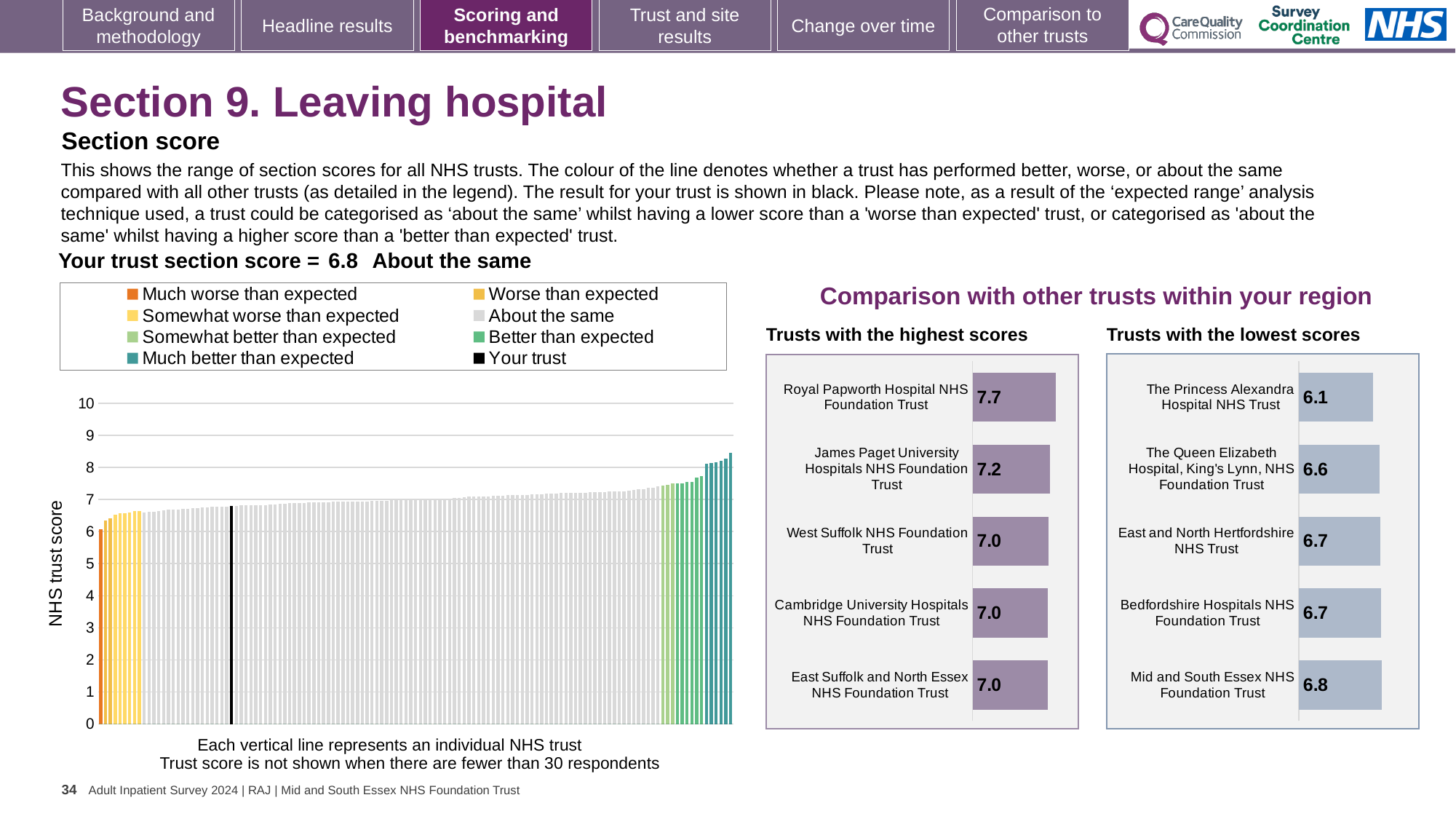
In the 'Trusts with the highest scores' chart, what is the difference between the scores of Royal Papworth Hospital NHS Foundation Trust and West Suffolk NHS Foundation Trust? 0.7 In the 'Trusts with the lowest scores' chart, what is the score for Mid and South Essex NHS Foundation Trust? 6.8 In the 'Trusts with the lowest scores' chart, which has the larger score: The Queen Elizabeth Hospital, King's Lynn, NHS Foundation Trust or Bedfordshire Hospitals NHS Foundation Trust? Bedfordshire Hospitals NHS Foundation Trust What kind of chart is the large chart on the left showing NHS trust scores? Bar chart In the 'Trusts with the highest scores' chart, what is the score for Royal Papworth Hospital NHS Foundation Trust? 7.7 How many trusts are shown in the 'Trusts with the highest scores' chart? 5 In the 'Trusts with the highest scores' chart, which trust has the highest score? Royal Papworth Hospital NHS Foundation Trust In the 'Trusts with the highest scores' chart, what is the score for James Paget University Hospitals NHS Foundation Trust? 7.2 In the 'Trusts with the lowest scores' chart, which trust has the lowest score? The Princess Alexandra Hospital NHS Trust In the 'Trusts with the lowest scores' chart, what is the score for The Princess Alexandra Hospital NHS Trust? 6.1 In the large chart on the left, do the trust scores rise or fall from left to right along the x axis? Rise How many entries does the legend of the large chart on the left list? 8